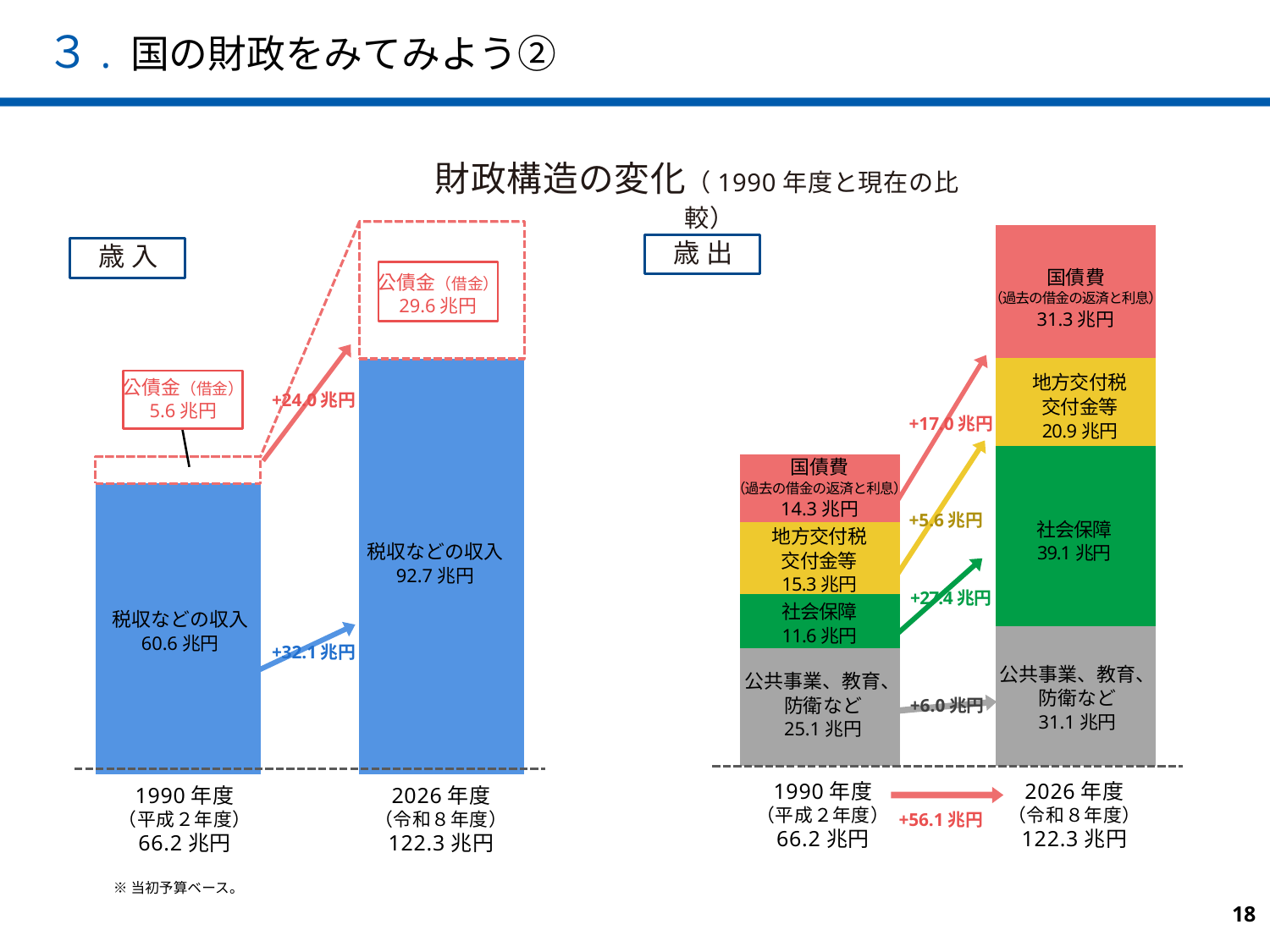
歳入のグラフで、「税収などの収入」は1990年度から2026年度にかけていくら増えましたか？ +32.1兆円 歳入のグラフで、1990年度の「公債金（借金）」はいくらですか？ 5.6兆円 歳出のグラフで、1990年度の4項目のうち最も小さいのはどれですか？ 社会保障 歳出のグラフで、2026年度の「社会保障」はいくらですか？ 39.1兆円 歳出のグラフで、「社会保障」は1990年度から2026年度にかけていくら増えましたか？ +27.4兆円 歳出のグラフで、1990年度の「国債費」はいくらですか？ 14.3兆円 歳出のグラフで、2026年度の4項目のうち最も大きいのはどれですか？ 社会保障 歳出のグラフで、2026年度の「国債費」と「公共事業、教育、防衛など」ではどちらが大きいですか？ 国債費 歳入のグラフで、2026年度の「税収などの収入」はいくらですか？ 92.7兆円 歳入のグラフで、2026年度の歳入合計はいくらですか？ 122.3兆円 歳出のグラフで、1990年度の積み上げ棒は何項目で構成されていますか？ 4 歳出のグラフはどの種類のグラフですか？ 積み上げ棒グラフ